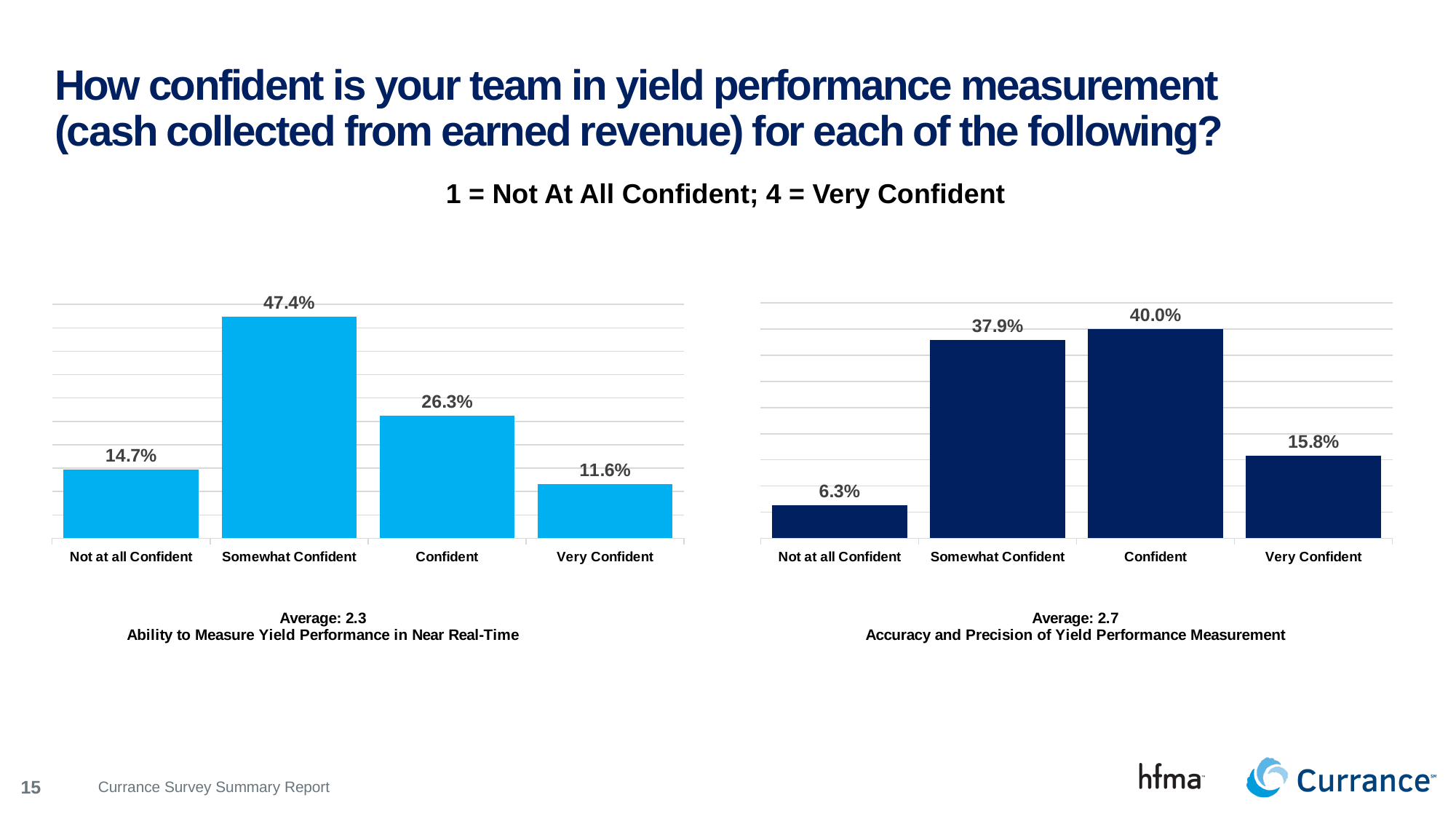
In the right chart (Accuracy and Precision of Yield Performance Measurement), which category has the highest value? Confident In the right chart (Accuracy and Precision of Yield Performance Measurement), what is the difference between Confident and Very Confident? 24.2% How many categories are shown in the left chart (Ability to Measure Yield Performance in Near Real-Time)? 4 What average is shown below the right chart (Accuracy and Precision of Yield Performance Measurement)? 2.7 In the right chart (Accuracy and Precision of Yield Performance Measurement), which is larger: Somewhat Confident or Very Confident? Somewhat Confident In the left chart (Ability to Measure Yield Performance in Near Real-Time), what is the difference between Somewhat Confident and Confident? 21.1% In the right chart (Accuracy and Precision of Yield Performance Measurement), what is the value for Not at all Confident? 6.3% What average is shown below the left chart (Ability to Measure Yield Performance in Near Real-Time)? 2.3 In the left chart (Ability to Measure Yield Performance in Near Real-Time), what is the value for Very Confident? 11.6% What kind of chart is the right chart (Accuracy and Precision of Yield Performance Measurement)? Bar chart In the left chart (Ability to Measure Yield Performance in Near Real-Time), what is the value for Somewhat Confident? 47.4% In the left chart (Ability to Measure Yield Performance in Near Real-Time), which category has the lowest value? Very Confident